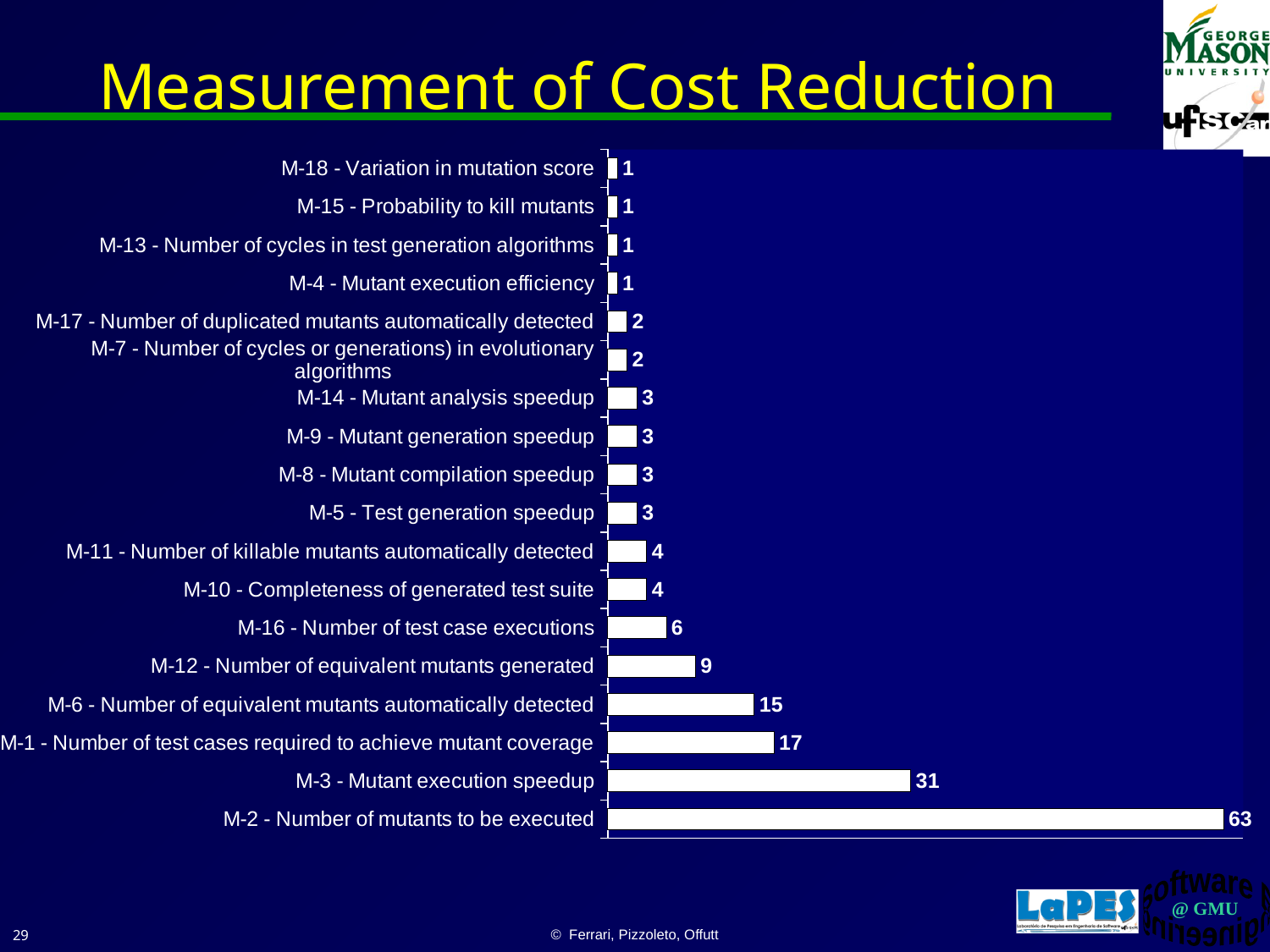
Which category has the highest value? M-2 - Number of mutants to be executed What kind of chart is shown on the slide? bar chart What is the value for M-2 - Number of mutants to be executed? 63 Which is larger, the value for M-12 - Number of equivalent mutants generated or the value for M-16 - Number of test case executions? M-12 - Number of equivalent mutants generated What is the value for M-6 - Number of equivalent mutants automatically detected? 15 What is the difference between the values for M-2 - Number of mutants to be executed and M-3 - Mutant execution speedup? 32 What is the title of the slide containing the chart? Measurement of Cost Reduction What is the value for M-17 - Number of duplicated mutants automatically detected? 2 What is the value for M-3 - Mutant execution speedup? 31 How many categories are plotted in the chart? 18 What is the difference between the values for M-1 - Number of test cases required to achieve mutant coverage and M-6 - Number of equivalent mutants automatically detected? 2 What is the value for M-16 - Number of test case executions? 6